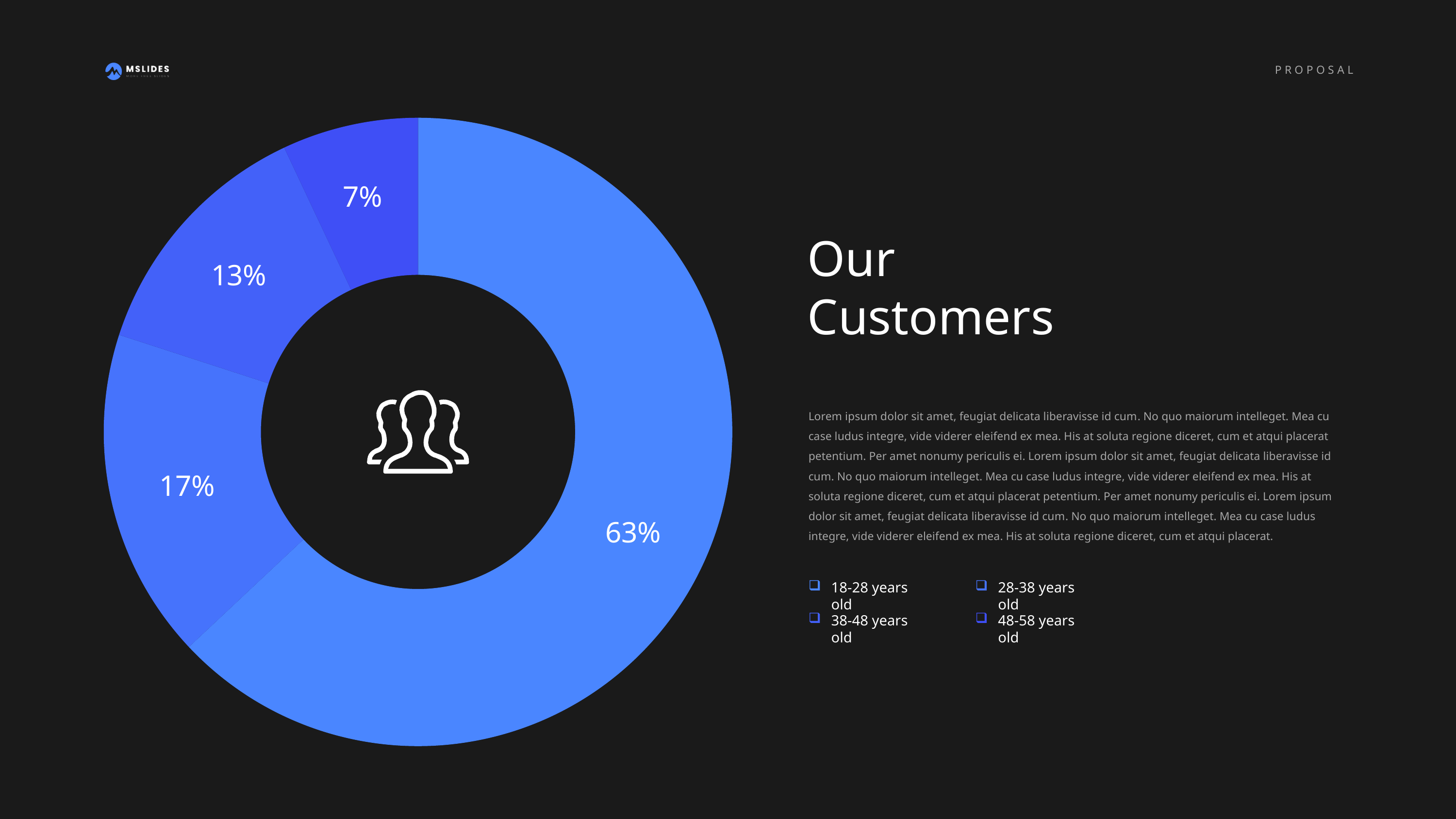
What kind of chart is shown on the slide? Doughnut chart What is the total of all four slice values shown on the doughnut chart? 100% What is the second-largest slice value shown on the doughnut chart? 17% What icon is shown in the centre of the doughnut chart? A group of people What is the value of the smallest slice in the doughnut chart? 7% What is the difference between the 17% slice and the 13% slice? 4% How many slices does the doughnut chart have? 4 Which is larger, the 13% slice or the 17% slice? 17% What is the title of the slide containing the doughnut chart? Our Customers What is the value of the largest slice in the doughnut chart? 63% What is the difference between the largest slice (63%) and the smallest slice (7%)? 56% How many age-group entries are listed in the legend beside the chart? 4